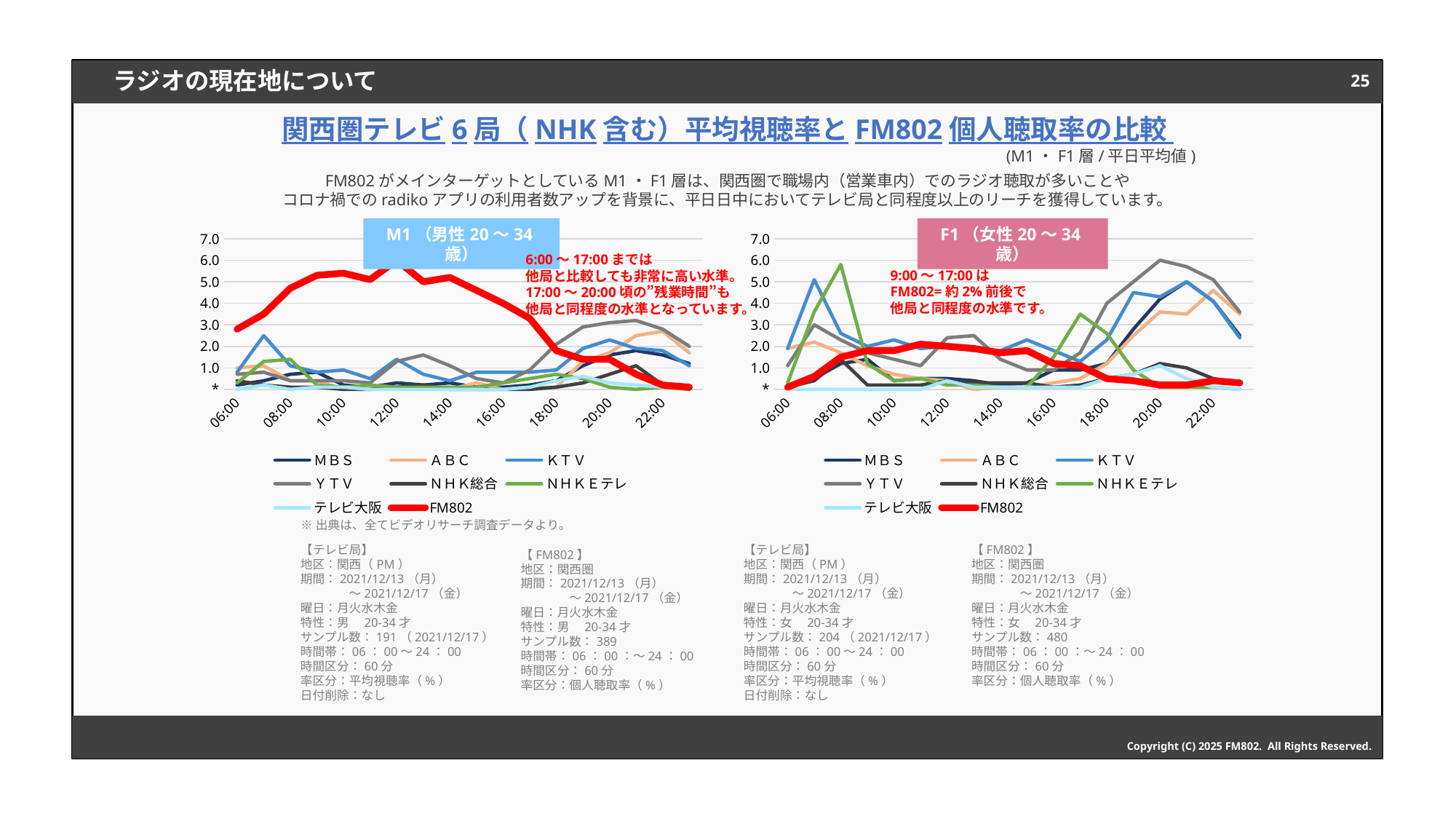
In the M1（男性 20～34歳）chart, is the FM802 value at 22:00 greater or less than 1.0? less In the M1（男性 20～34歳）chart, is the FM802 value at 06:00 greater or less than 2.0? greater What is the highest value shown on the y axis of the F1（女性 20～34歳）chart? 7.0 How many time labels are shown on the x axis of the M1（男性 20～34歳）chart? 9 In the F1（女性 20～34歳）chart, is the FM802 value at 12:00 greater or less than 1.0? greater In the M1（男性 20～34歳）chart, does the FM802 line rise or fall from 14:00 to 22:00? fall What kind of chart is the M1（男性 20～34歳）chart on the left? line chart In the F1（女性 20～34歳）chart, which series reaches the highest value at 20:00? YTV How many series does the legend of the F1（女性 20～34歳）chart list? 8 In the M1（男性 20～34歳）chart, which series has the highest value at 10:00? FM802